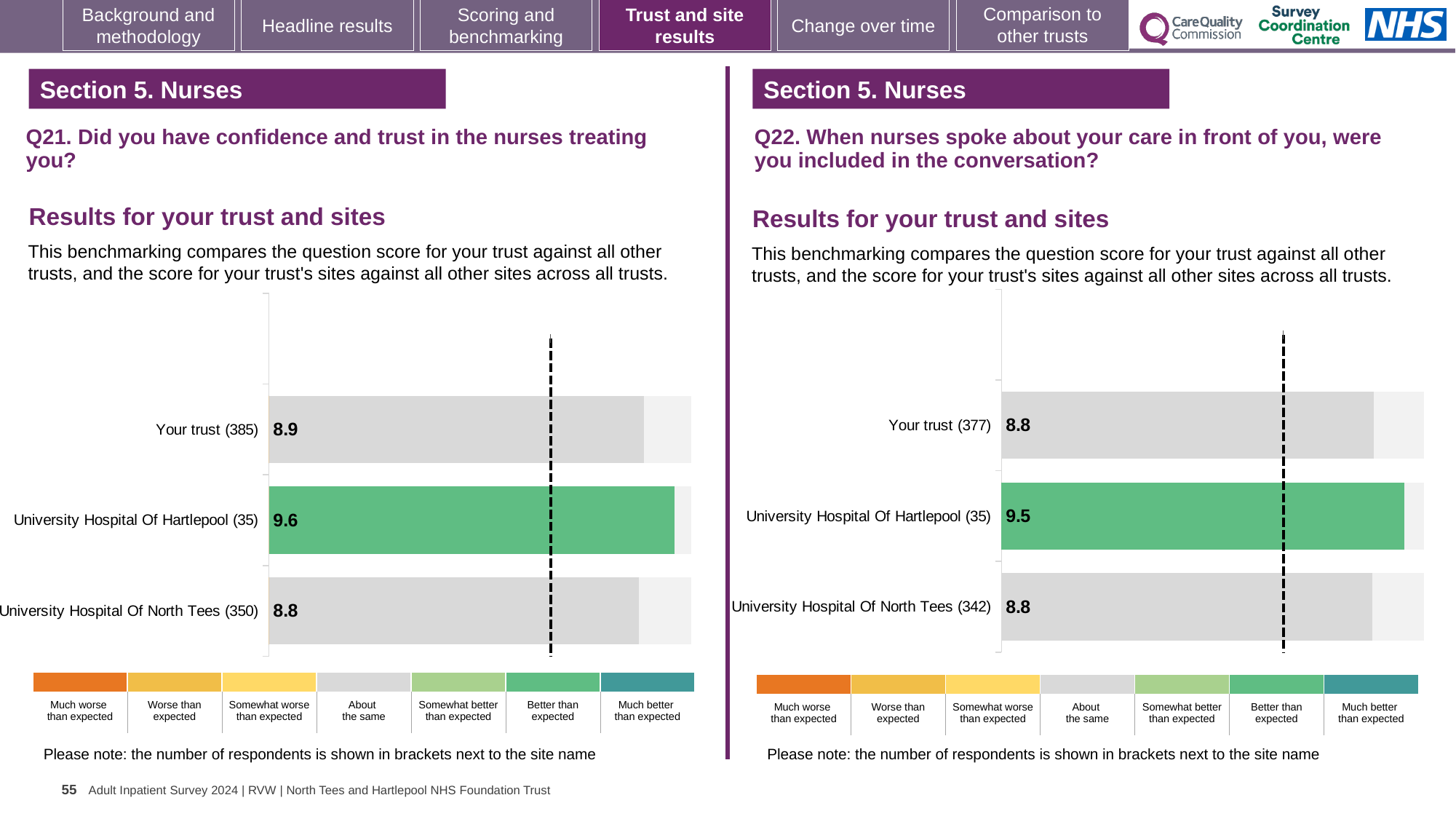
In the Q21 chart (left), which site or trust has the highest score? University Hospital Of Hartlepool (35) How many bars are plotted in the Q21 chart (left)? 3 In the Q22 chart (right), what is the difference between the scores for University Hospital Of Hartlepool and Your trust? 0.7 In the Q22 chart (right), what is the score for Your trust (377)? 8.8 In the Q22 chart (right), what is the score for University Hospital Of North Tees (342)? 8.8 In the Q21 chart (left), what is the score for Your trust (385)? 8.9 In the Q21 chart (left), what is the score for University Hospital Of Hartlepool (35)? 9.6 In the Q21 chart (left), what is the difference between the scores for University Hospital Of Hartlepool and University Hospital Of North Tees? 0.8 What type of chart is used for the Q22 results (right)? Bar chart In the Q22 chart (right), what is the score for University Hospital Of Hartlepool (35)? 9.5 In the Q22 chart (right), which site has the highest score? University Hospital Of Hartlepool (35) In the Q21 chart (left), what is the score for University Hospital Of North Tees (350)? 8.8